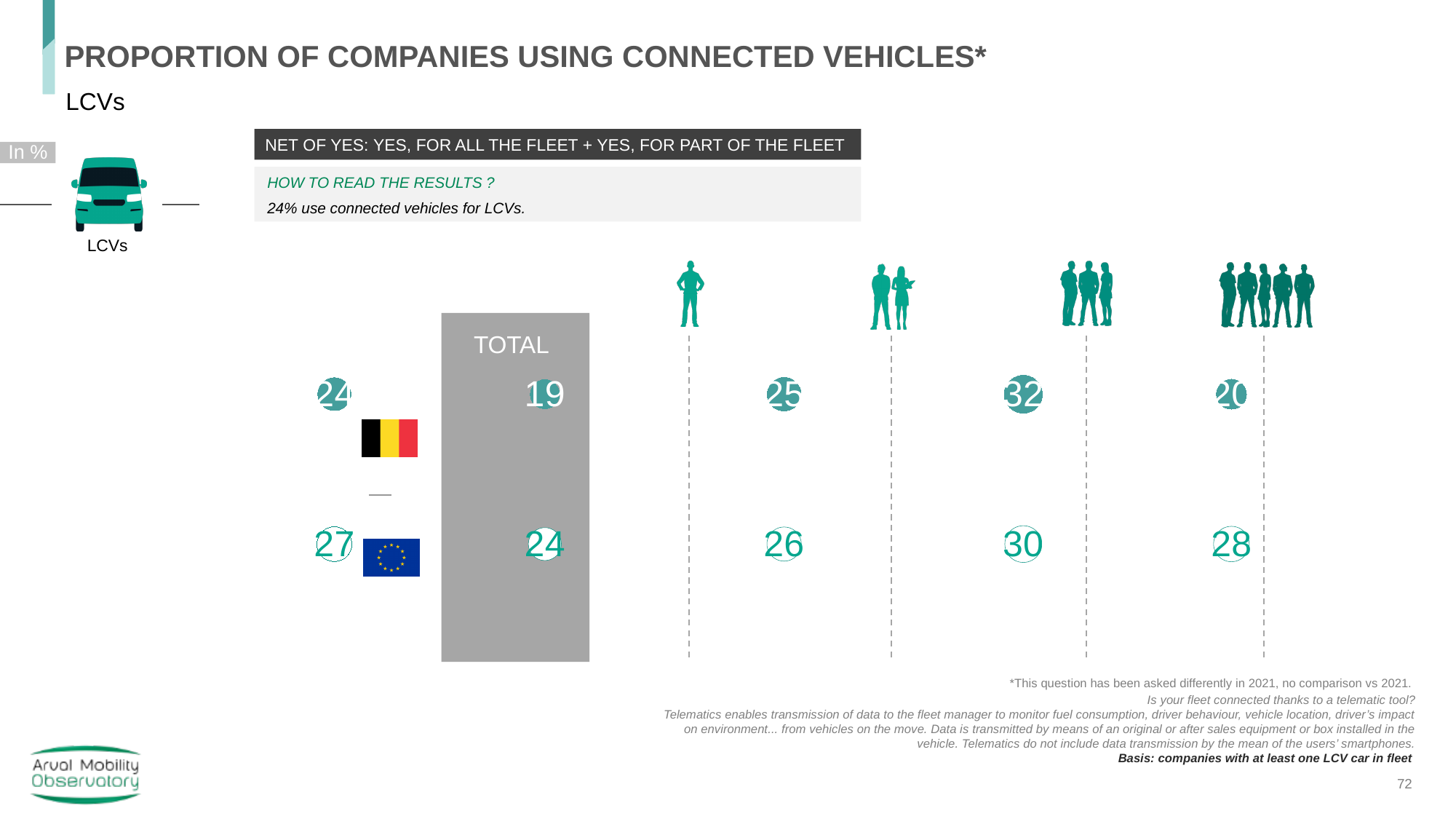
What is the Europe value in the column marked with the five-person icon? 28 What is the Belgium value in the column marked with the three-person icon? 32 How many rows (countries/regions) of values are shown in the chart? 2 What value is shown in the circle directly next to the Belgian flag? 24 In the column marked with the two-person icon, which is larger: the Belgium value or the Europe value? Europe (26) What is the difference between the Europe and Belgium values in the TOTAL column? 5 What is the difference between the Belgium and Europe values in the three-person icon column? 2 Which company-size column has the highest value for Belgium? The three-person icon column (32) What is the value for Belgium in the TOTAL column? 19 What is the value for Europe (EU flag) in the TOTAL column? 24 What value is shown in the circle directly next to the EU flag? 27 In what unit are the values on the chart expressed? In %